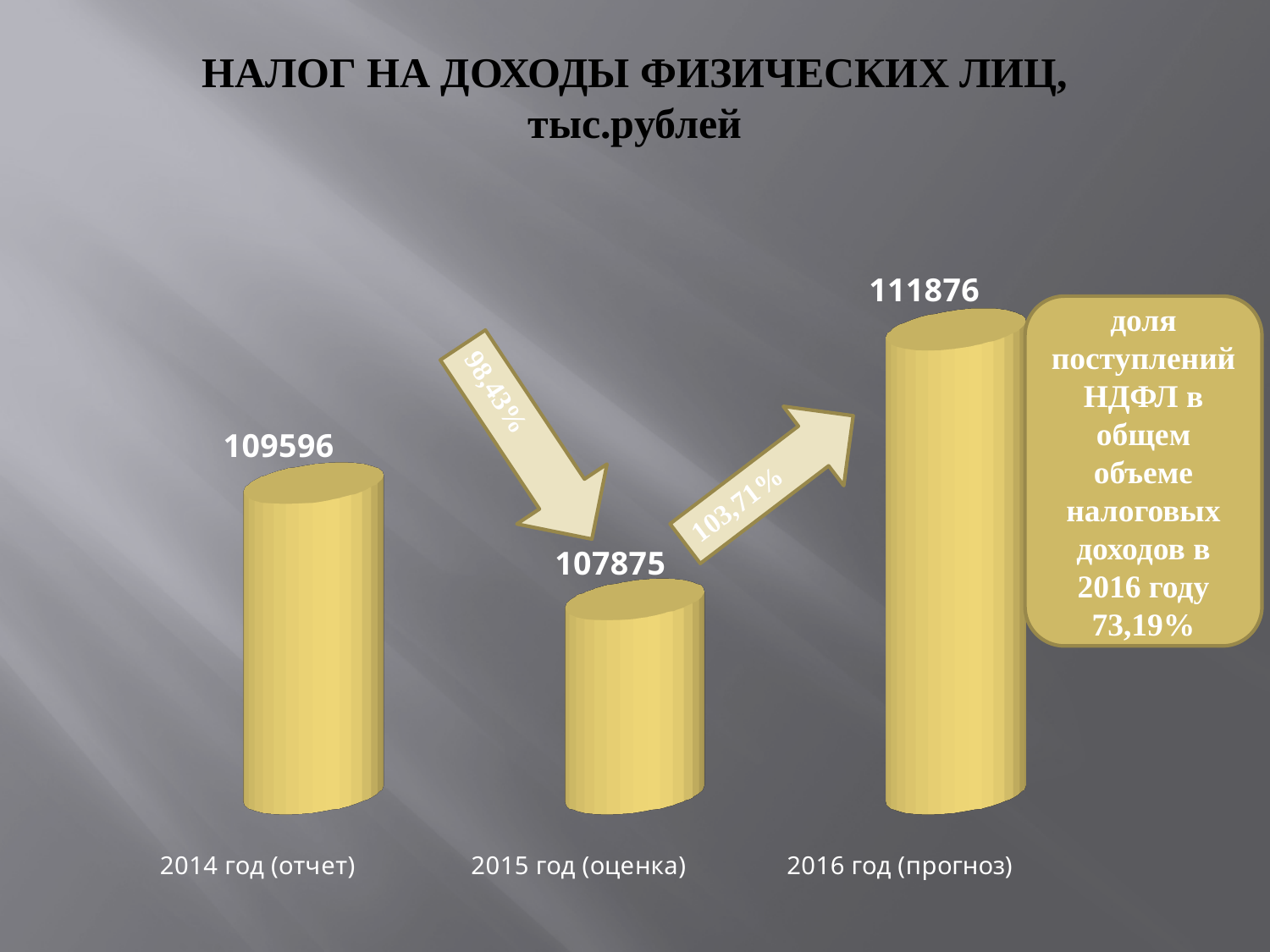
What kind of chart is shown on the slide? bar chart What is the value for 2014 год (отчет)? 109596 How many categories are shown in the chart? 3 What is the difference between the values for 2016 год (прогноз) and 2015 год (оценка)? 4001 What unit is given in the chart title? тыс.рублей What is the value for 2016 год (прогноз)? 111876 Which category has the highest value? 2016 год (прогноз) Which is larger, the value for 2014 год (отчет) or the value for 2016 год (прогноз)? 2016 год (прогноз) What is the difference between the values for 2014 год (отчет) and 2015 год (оценка)? 1721 What percentage is shown on the arrow between 2015 год (оценка) and 2016 год (прогноз)? 103,71% What is the value for 2015 год (оценка)? 107875 Which category has the lowest value? 2015 год (оценка)